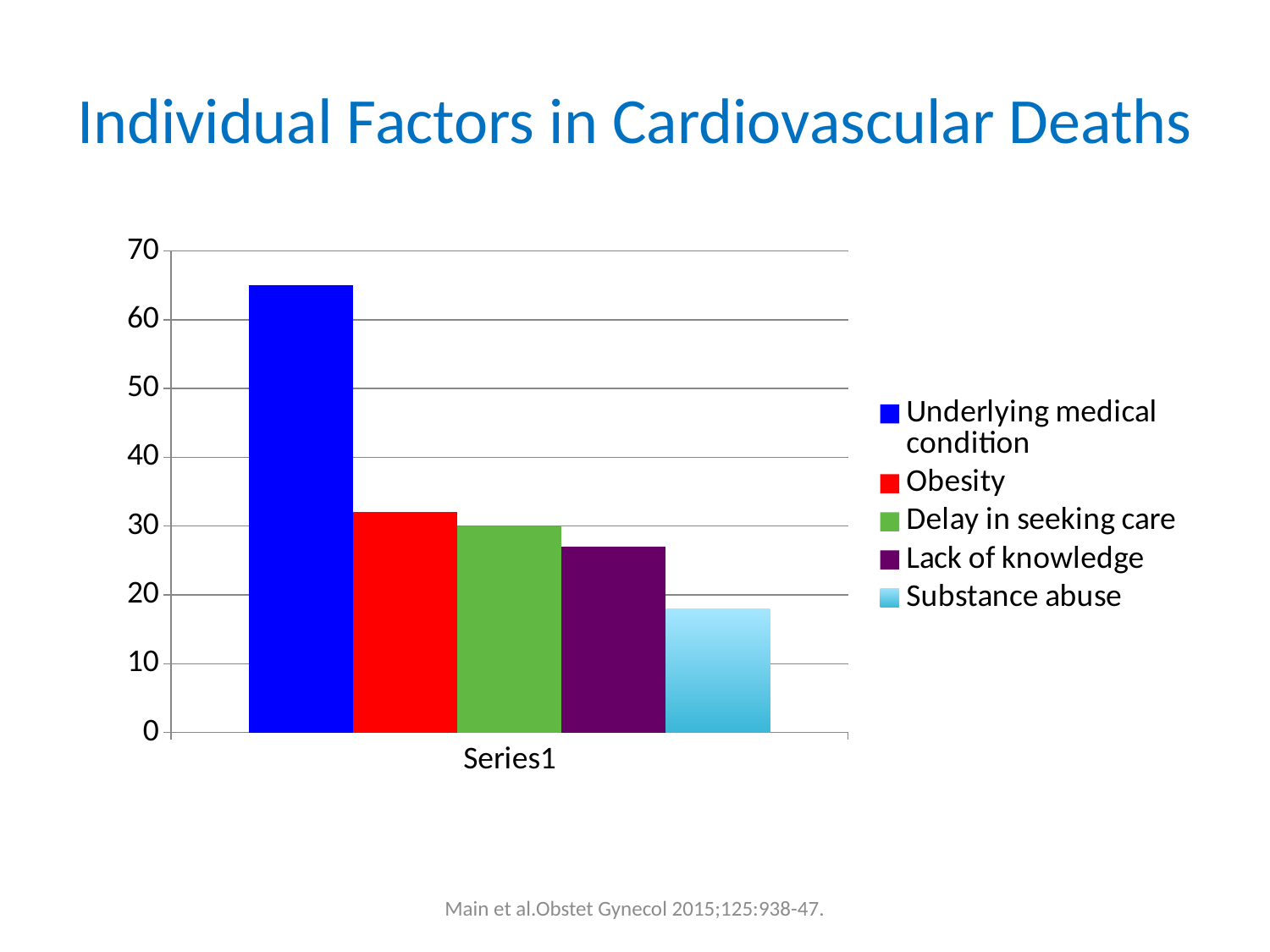
Which is larger, the value for Underlying medical condition or the value for Lack of knowledge? Underlying medical condition Which factor has the highest bar? Underlying medical condition What is the title of the slide containing the chart? Individual Factors in Cardiovascular Deaths Which is larger, the value for Obesity or the value for Substance abuse? Obesity Is the value for Underlying medical condition greater or less than 60? greater Is the value for Obesity greater or less than 40? less Is the value for Substance abuse greater or less than 20? less Which factor has the lowest bar? Substance abuse How many series does the legend list? 5 What kind of chart is shown on the slide? bar chart How many bars are plotted in the chart? 5